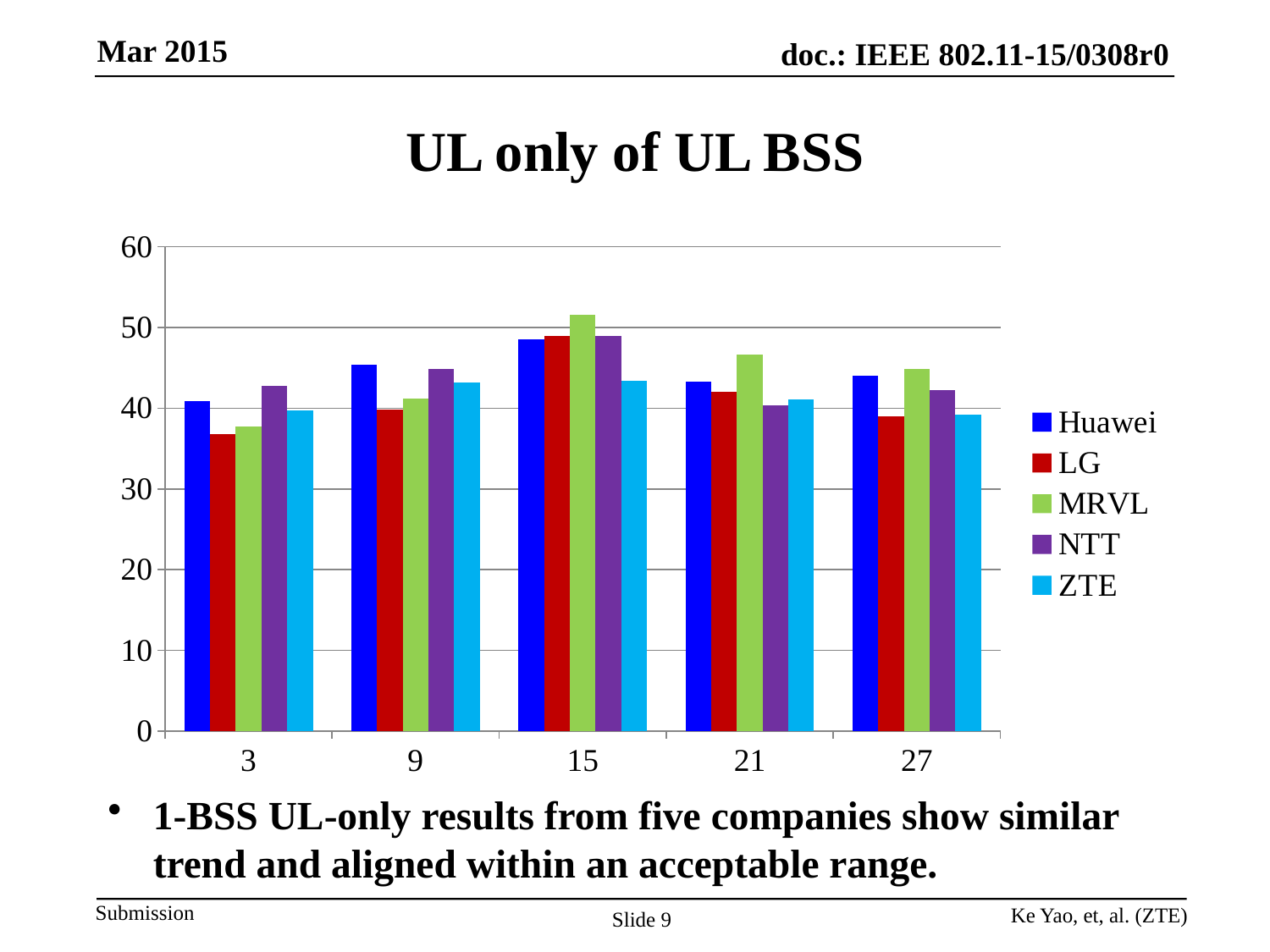
How many categories are shown on the x axis? 5 How many series does the legend list? 5 What is the title of the chart? UL only of UL BSS At which category does the LG series have its lowest value? 3 What kind of chart is shown on the slide? bar chart Is the value for Huawei at category 21 greater or less than 40? greater At category 9, which is larger, the Huawei value or the LG value? Huawei Is the value for MRVL at category 15 greater or less than 50? greater At which category does the MRVL series reach its highest value? 15 Is the value for LG at category 3 greater or less than 40? less Which series has the highest bar at category 15? MRVL Which series is shown in red in the legend? LG